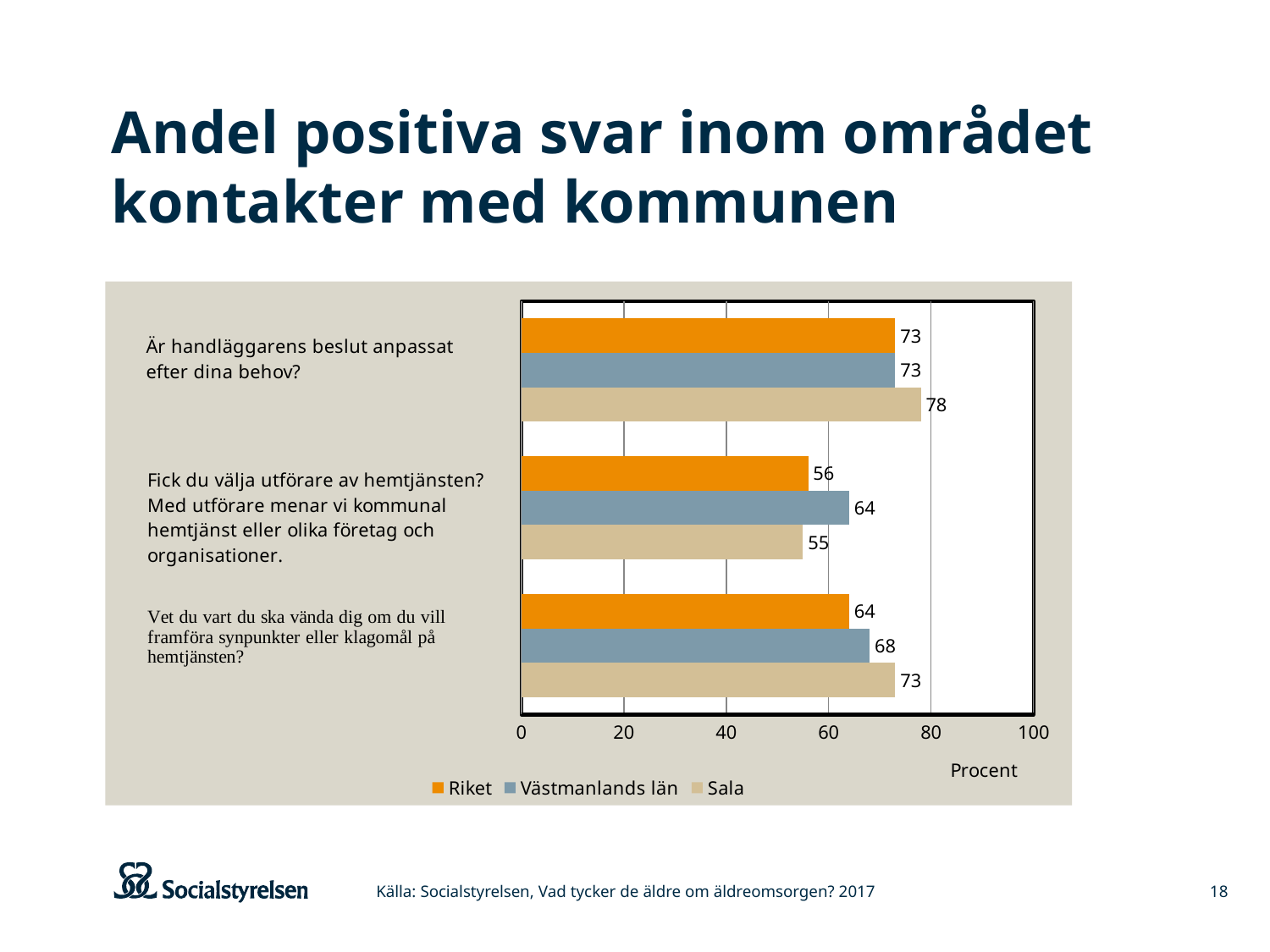
How many question categories are shown on the chart? 3 Which series has the highest value on the question "Fick du välja utförare av hemtjänsten?"? Västmanlands län What is the value for Västmanlands län on the question "Vet du vart du ska vända dig om du vill framföra synpunkter eller klagomål på hemtjänsten?"? 68 Which series has the lowest value on the question "Vet du vart du ska vända dig om du vill framföra synpunkter eller klagomål på hemtjänsten?"? Riket What is the difference between Västmanlands län and Sala on the question "Fick du välja utförare av hemtjänsten?"? 9 What is the value for Sala on the question "Är handläggarens beslut anpassat efter dina behov?"? 78 Which is larger: Sala on "Vet du vart du ska vända dig..." or Sala on "Fick du välja utförare av hemtjänsten?"? Sala on "Vet du vart du ska vända dig..." What is the value for Riket on the question "Fick du välja utförare av hemtjänsten?"? 56 Is the value for Riket on "Är handläggarens beslut anpassat efter dina behov?" greater or less than 60? greater What is the difference between Sala and Riket on the question "Är handläggarens beslut anpassat efter dina behov?"? 5 What kind of chart is shown on the slide? Bar chart How many series does the legend list? 3